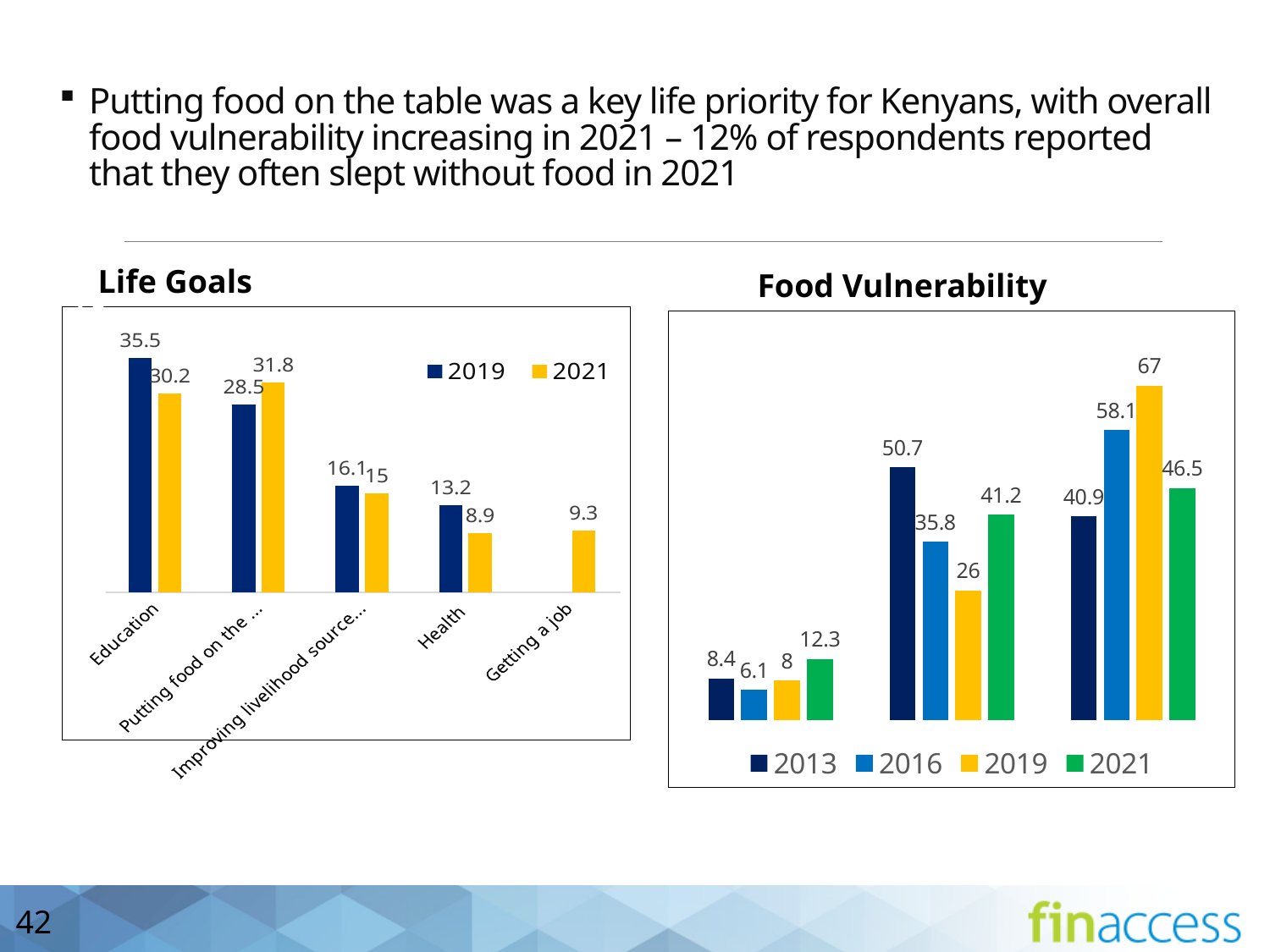
How many series does the legend of the Food Vulnerability chart list? 4 What kind of chart is the Life Goals chart? bar chart In the Life Goals chart, is the 2019 or the 2021 value larger for Health? 2019 In the Life Goals chart, what is the value for Health in 2021? 8.9 In the Food Vulnerability chart, what is the highest value shown? 67 In the Food Vulnerability chart, what is the lowest value shown? 6.1 In the Life Goals chart, what is the difference between the 2019 and 2021 values for Education? 5.3 In the Life Goals chart, what is the 2021 value for Getting a job? 9.3 In the Life Goals chart, which category has the highest 2021 value? Putting food on the... How many categories are shown on the x axis of the Life Goals chart? 5 How many series does the legend of the Life Goals chart list? 2 In the Life Goals chart, what is the value for Education in 2019? 35.5